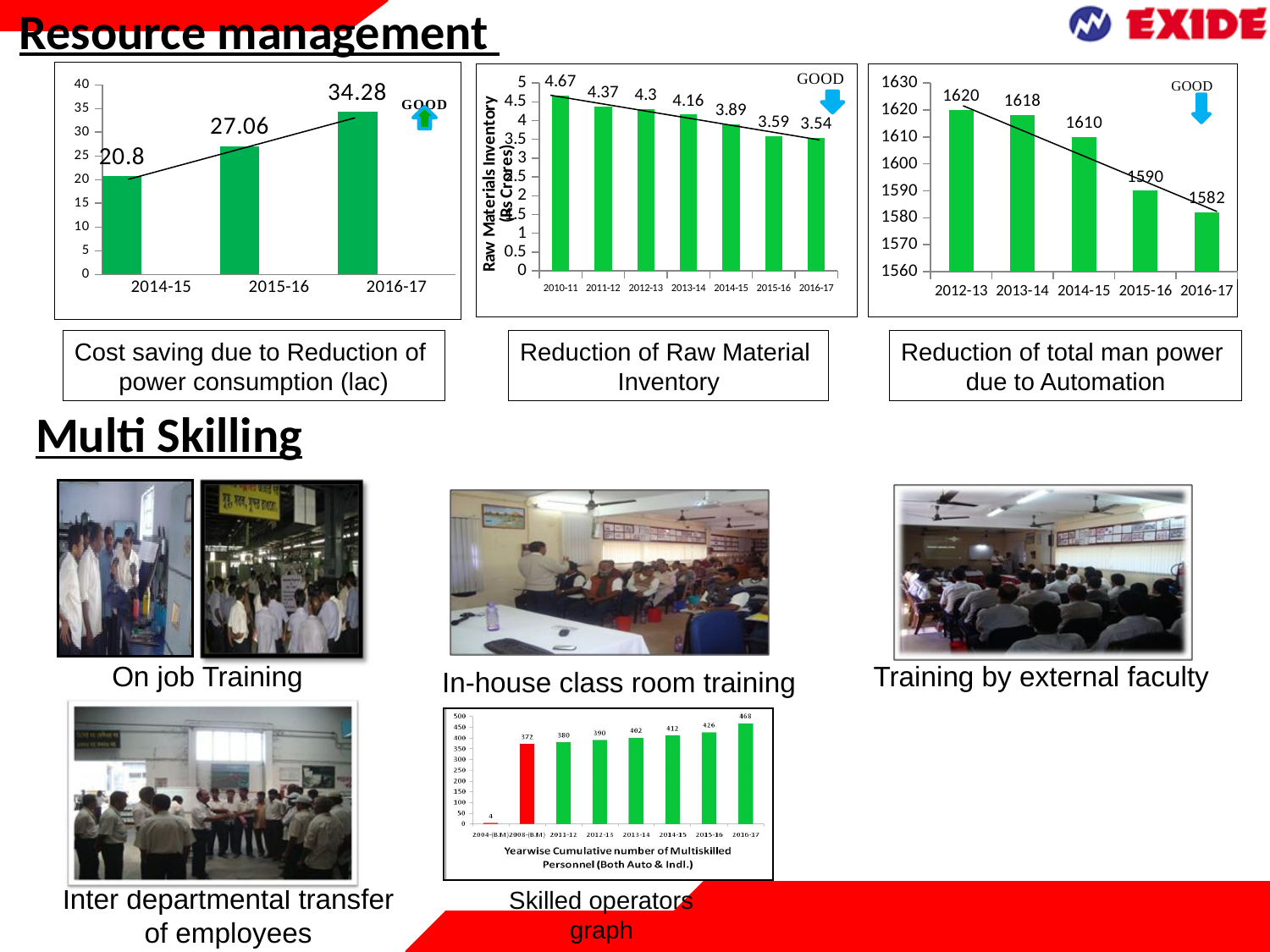
In the top-middle chart on reduction of raw material inventory, which year has the highest value? 2010-11 In the top-middle chart on reduction of raw material inventory, what is the y-axis title? Raw Materials Inventory (Rs Crores) In the top-middle chart on reduction of raw material inventory, what is the value for 2013-14? 4.16 In the bottom skilled operators graph, what is the value for 2016-17? 468 In the top-right chart on reduction of total man power due to automation, what is the difference between the 2012-13 and 2016-17 values? 38 In the top-left chart on cost saving due to reduction of power consumption, what is the value for 2016-17? 34.28 In the top-left chart on cost saving due to reduction of power consumption, what is the difference between the 2016-17 and 2014-15 values? 13.48 What type of chart is the top-right chart on reduction of total man power due to automation? bar chart In the top-right chart on reduction of total man power due to automation, which year has the lowest value? 2016-17 In the top-left chart on cost saving due to reduction of power consumption, do the values rise or fall from 2014-15 to 2016-17? rise In the top-right chart on reduction of total man power due to automation, what is the value for 2015-16? 1590 In the top-middle chart on reduction of raw material inventory, how many years are plotted? 7